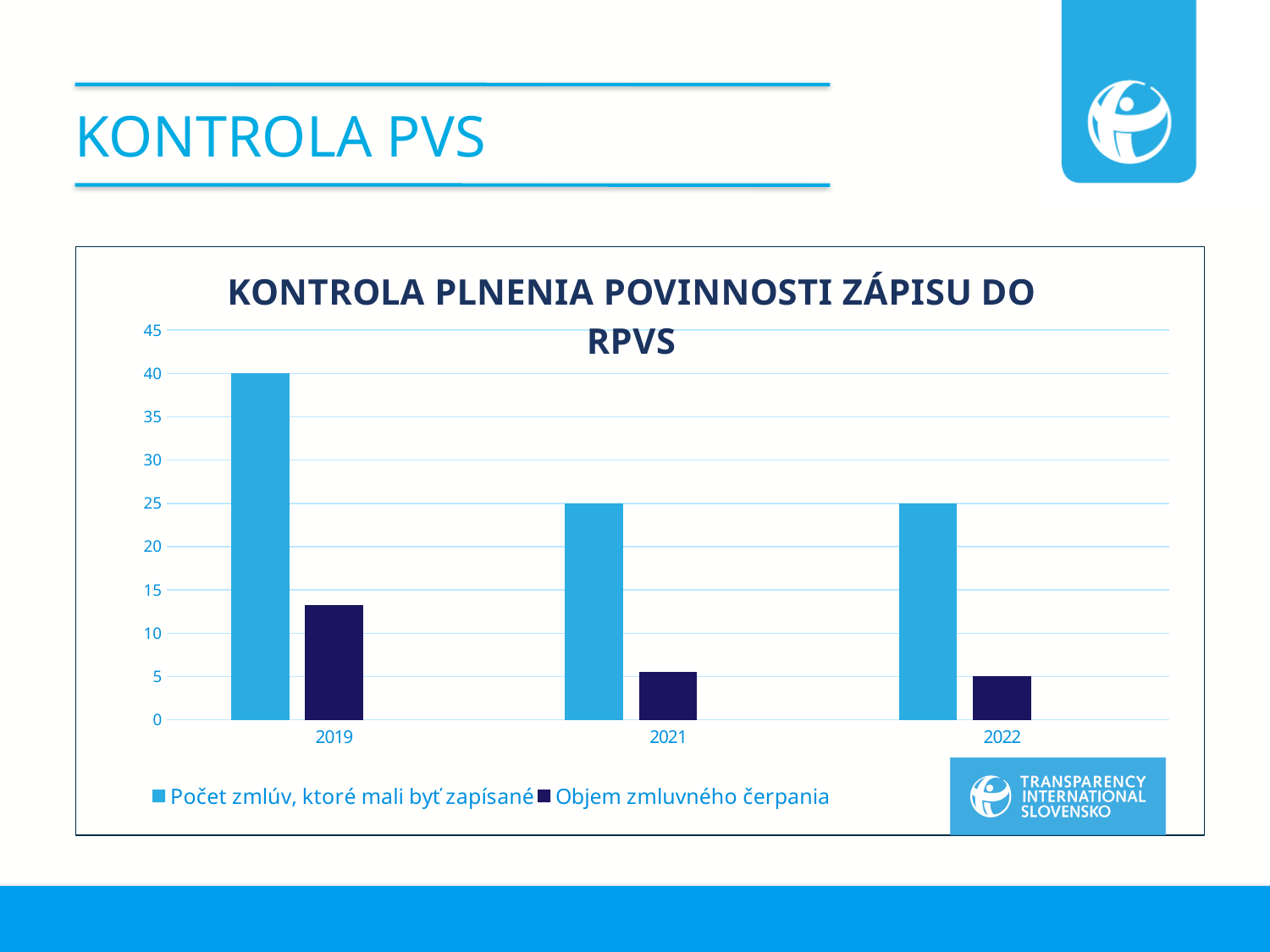
What is the value of 'Počet zmlúv, ktoré mali byť zapísané' for 2021? 25 What is the value of 'Počet zmlúv, ktoré mali byť zapísané' for 2019? 40 What is the title of the chart? KONTROLA PLNENIA POVINNOSTI ZÁPISU DO RPVS Is the value of 'Objem zmluvného čerpania' for 2022 greater or less than 10? less What kind of chart is shown on the slide? bar chart Which year has the highest value for 'Počet zmlúv, ktoré mali byť zapísané'? 2019 How many series does the legend list? 2 How many years are shown on the x axis? 3 What is the difference between 'Počet zmlúv, ktoré mali byť zapísané' in 2019 and in 2021? 15 What is the value of 'Počet zmlúv, ktoré mali byť zapísané' for 2022? 25 Which year has the highest value for 'Objem zmluvného čerpania'? 2019 Is the value of 'Objem zmluvného čerpania' for 2019 greater or less than 10? greater